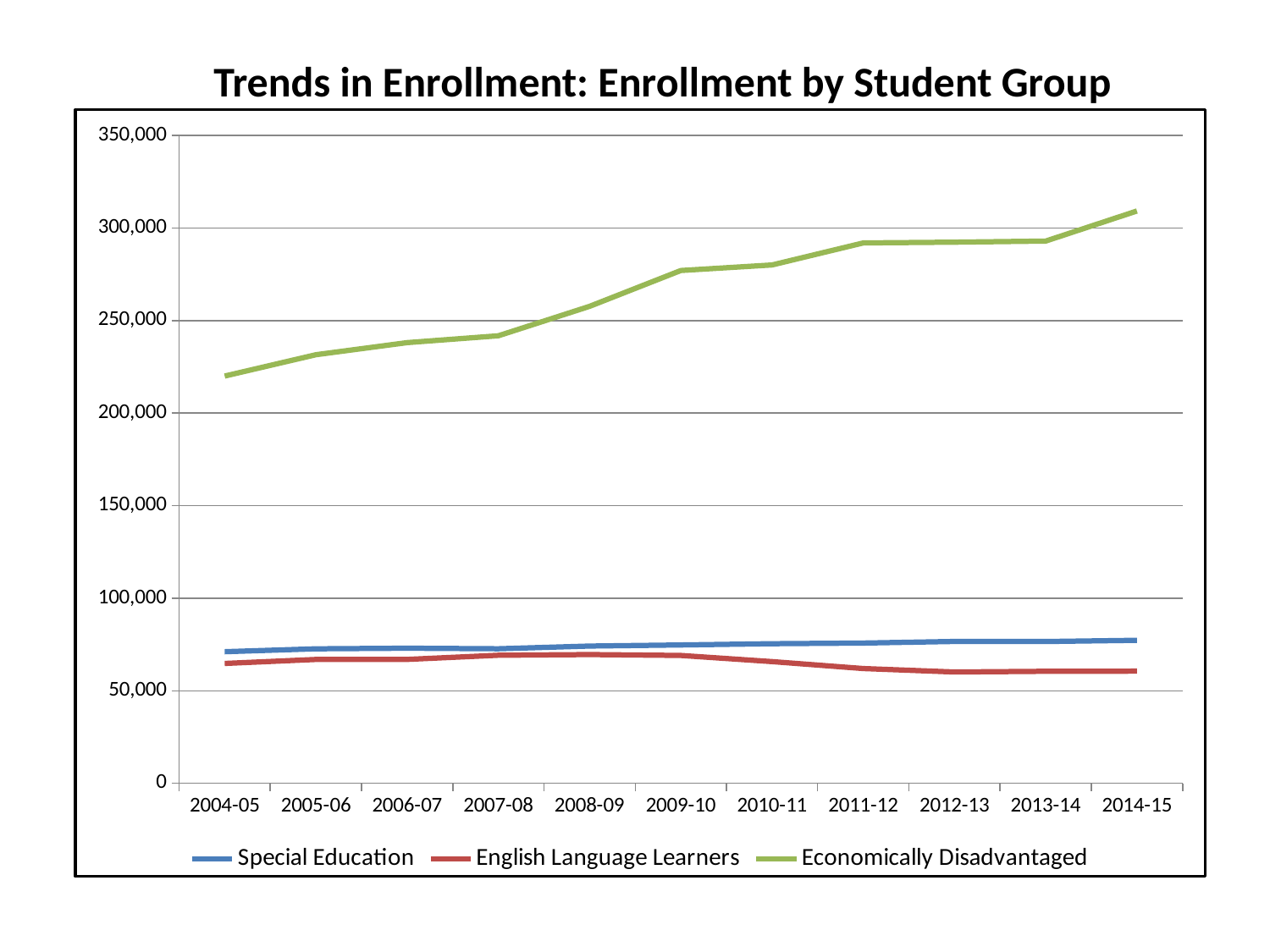
How many series does the legend list? 3 In which school year is Economically Disadvantaged enrollment lowest? 2004-05 In which school year is Economically Disadvantaged enrollment highest? 2014-15 Is the Economically Disadvantaged value for 2014-15 greater or less than 300,000? greater What is the title of the chart? Trends in Enrollment: Enrollment by Student Group Does Economically Disadvantaged enrollment rise or fall from 2004-05 to 2014-15? rise Which student group is represented by the green line? Economically Disadvantaged What kind of chart is shown on the slide? line chart Which student group has the highest enrollment in 2014-15? Economically Disadvantaged In 2014-15, which is larger: Special Education or English Language Learners enrollment? Special Education How many school years are shown on the x axis? 11 Is the English Language Learners value for 2014-15 greater or less than 100,000? less